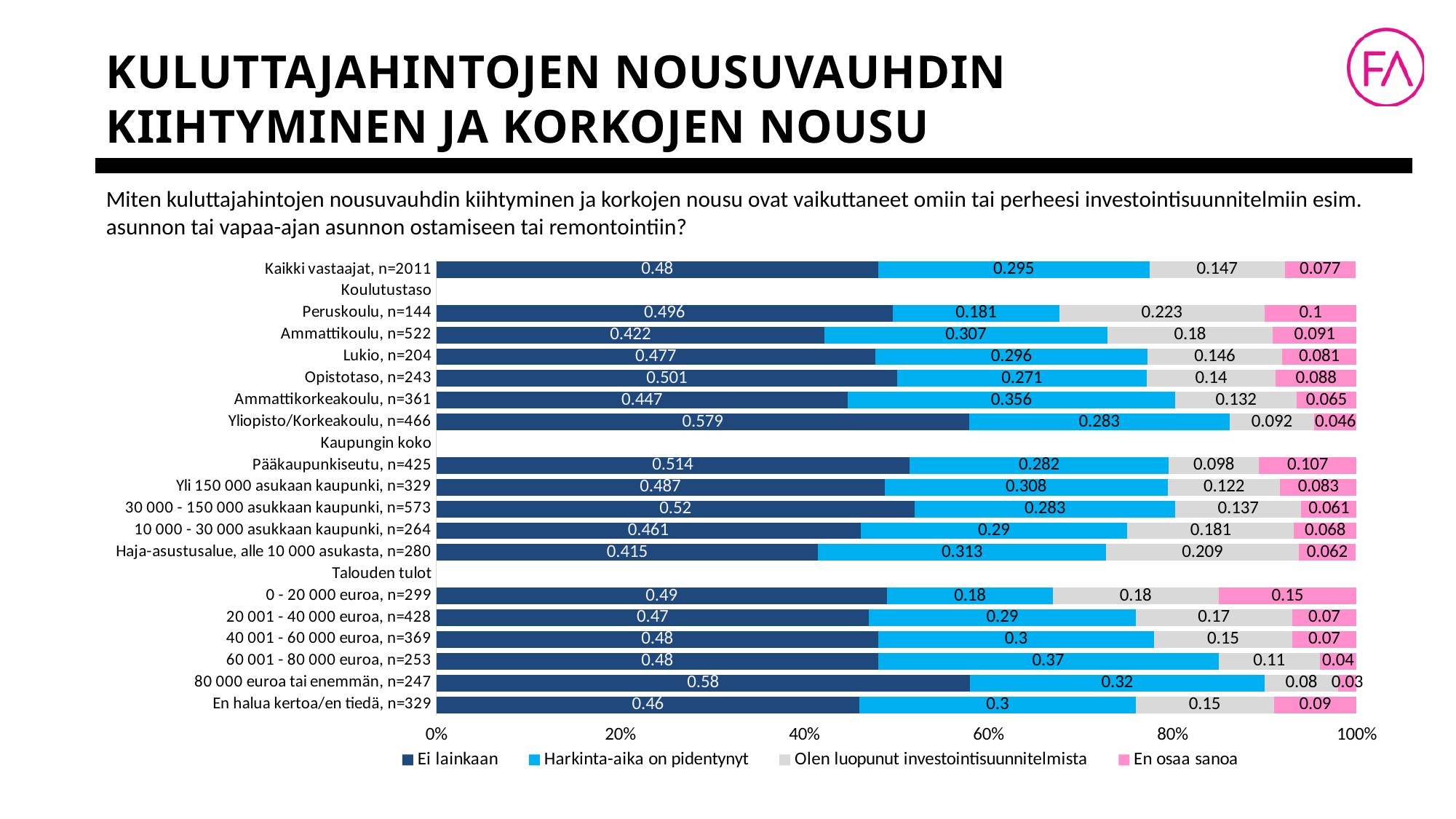
What is the value of 'Harkinta-aika on pidentynyt' for '60 001 - 80 000 euroa, n=253'? 0.37 How many respondent groups (bars) are plotted in the chart? 18 What is the value of 'En osaa sanoa' for 'Yliopisto/Korkeakoulu, n=466'? 0.046 For 'Kaikki vastaajat, n=2011', what is the difference between 'Ei lainkaan' and 'Harkinta-aika on pidentynyt'? 0.185 What is the value of 'Ei lainkaan' for 'Kaikki vastaajat, n=2011'? 0.48 How many series does the legend list? 4 Which legend entry is shown in pink? En osaa sanoa For 'Peruskoulu, n=144', which is larger: 'Harkinta-aika on pidentynyt' or 'Olen luopunut investointisuunnitelmista'? Olen luopunut investointisuunnitelmista Which category has the highest value for 'En osaa sanoa'? 0 - 20 000 euroa, n=299 What is the value of 'Olen luopunut investointisuunnitelmista' for 'Pääkaupunkiseutu, n=425'? 0.098 Which category has the lowest value for 'En osaa sanoa'? 80 000 euroa tai enemmän, n=247 What type of chart is shown on the slide? Stacked bar chart